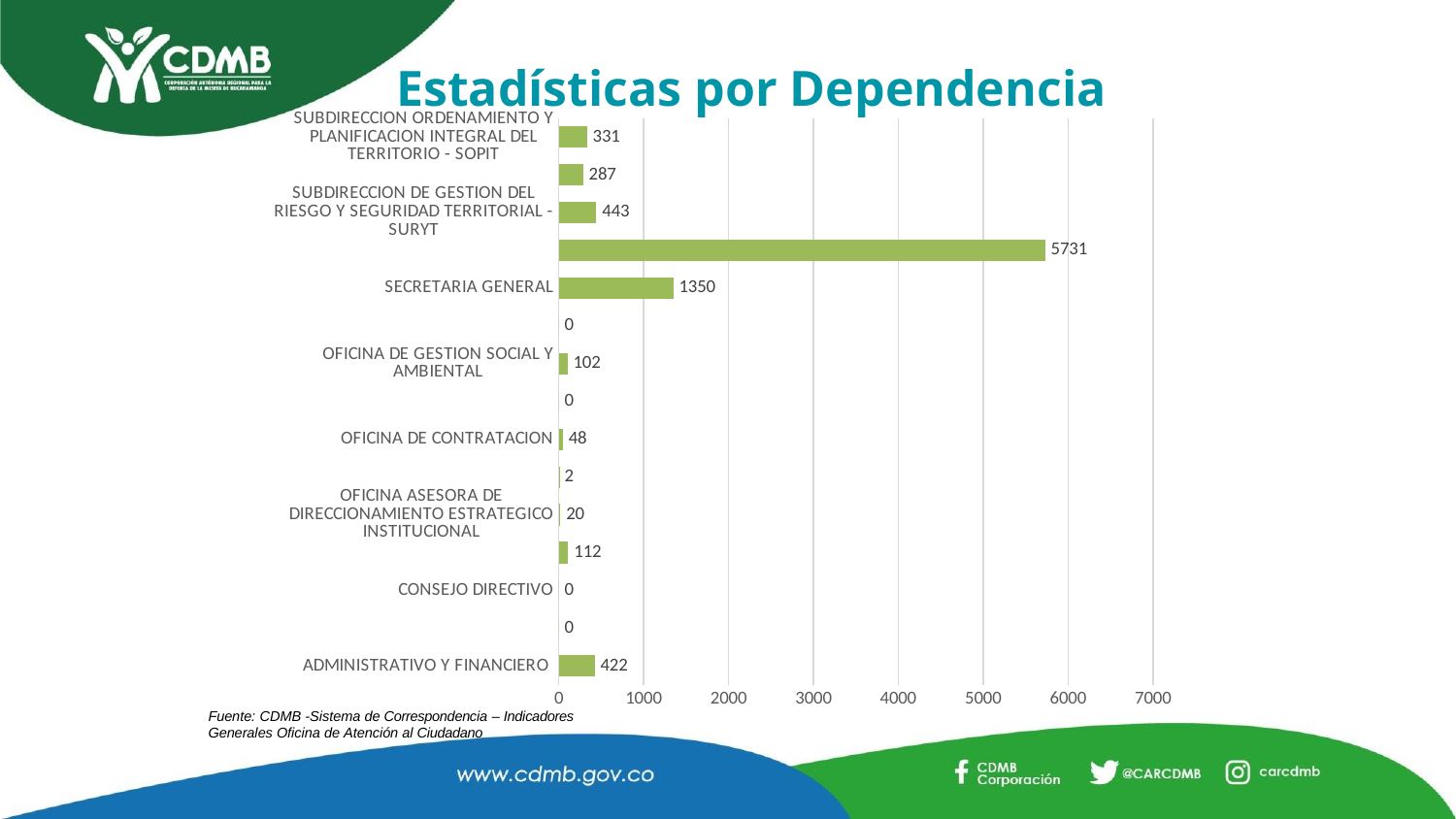
How many bars are plotted on the chart? 15 What is the title of the slide? Estadísticas por Dependencia What is the largest value shown on the chart? 5731 What kind of chart is shown on the slide? Bar chart What is the value for ADMINISTRATIVO Y FINANCIERO? 422 What is the value for OFICINA DE CONTRATACION? 48 What is the value for OFICINA DE GESTION SOCIAL Y AMBIENTAL? 102 What is the value for CONSEJO DIRECTIVO? 0 Which has a larger value, SUBDIRECCION DE GESTION DEL RIESGO Y SEGURIDAD TERRITORIAL - SURYT or SUBDIRECCION ORDENAMIENTO Y PLANIFICACION INTEGRAL DEL TERRITORIO - SOPIT? SUBDIRECCION DE GESTION DEL RIESGO Y SEGURIDAD TERRITORIAL - SURYT What is the difference between the values for SECRETARIA GENERAL and ADMINISTRATIVO Y FINANCIERO? 928 What is the value for SECRETARIA GENERAL? 1350 Is the value for SECRETARIA GENERAL greater or less than 1000? greater